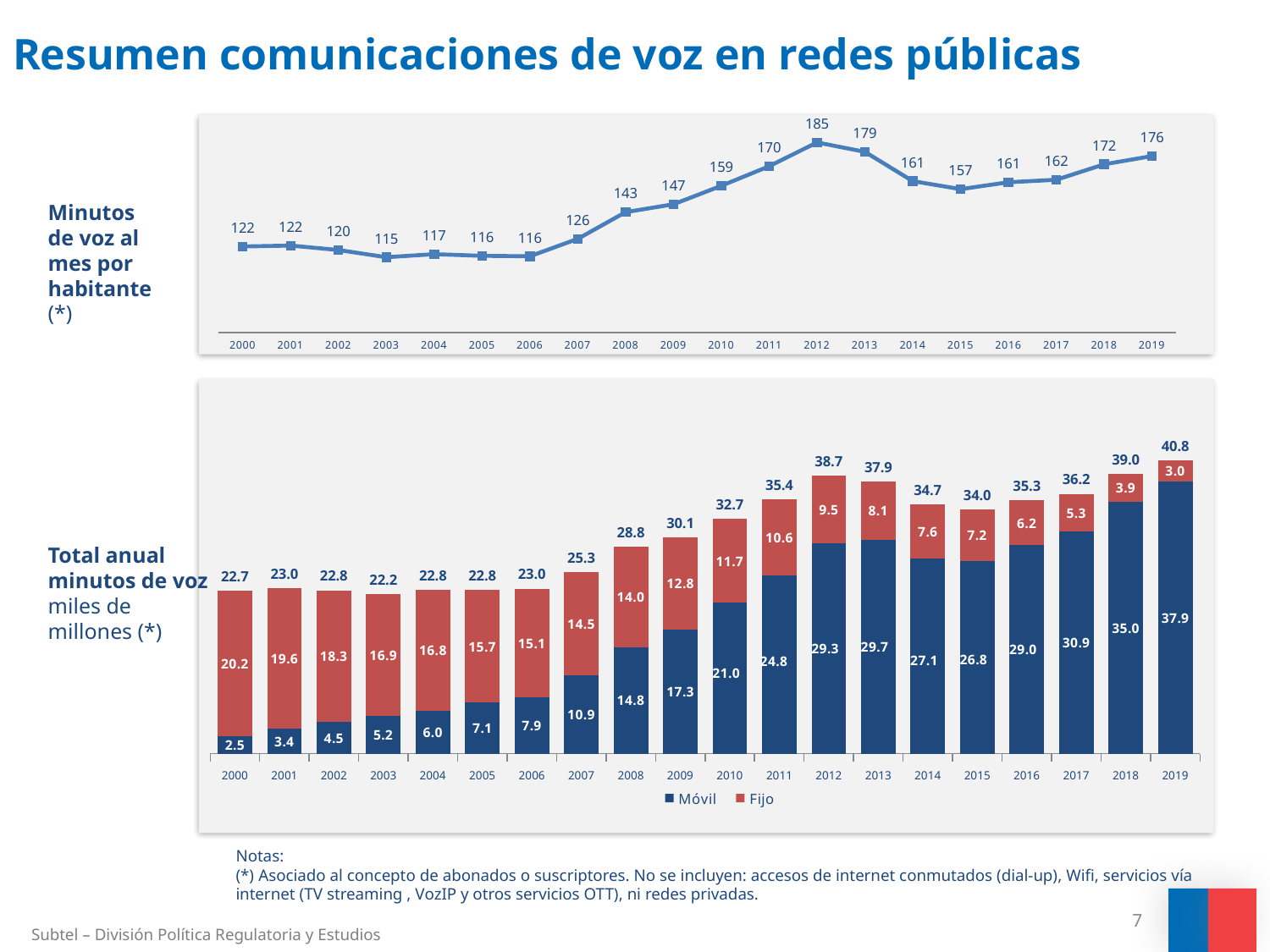
In the bottom chart (Total anual minutos de voz), is the Móvil value for 2008 larger or the Fijo value for 2008? Móvil In the bottom chart (Total anual minutos de voz), what is the total of the stacked bar for 2019? 40.8 In the bottom chart (Total anual minutos de voz), which year has the lowest total? 2003 In the bottom chart (Total anual minutos de voz), what is the Fijo value for 2000? 20.2 In the top chart (Minutos de voz al mes por habitante), which year has the lowest value? 2003 How many series does the legend of the bottom chart (Total anual minutos de voz) list? 2 In the bottom chart (Total anual minutos de voz), what is the Móvil value for 2010? 21.0 In the top chart (Minutos de voz al mes por habitante), what is the difference between the 2019 value and the 2000 value? 54 In the bottom chart (Total anual minutos de voz), does the Fijo value rise or fall from 2000 to 2019? Fall What kind of chart is the top chart (Minutos de voz al mes por habitante)? Line chart In the top chart (Minutos de voz al mes por habitante), which year has the highest value? 2012 In the top chart (Minutos de voz al mes por habitante), what is the value for 2012? 185